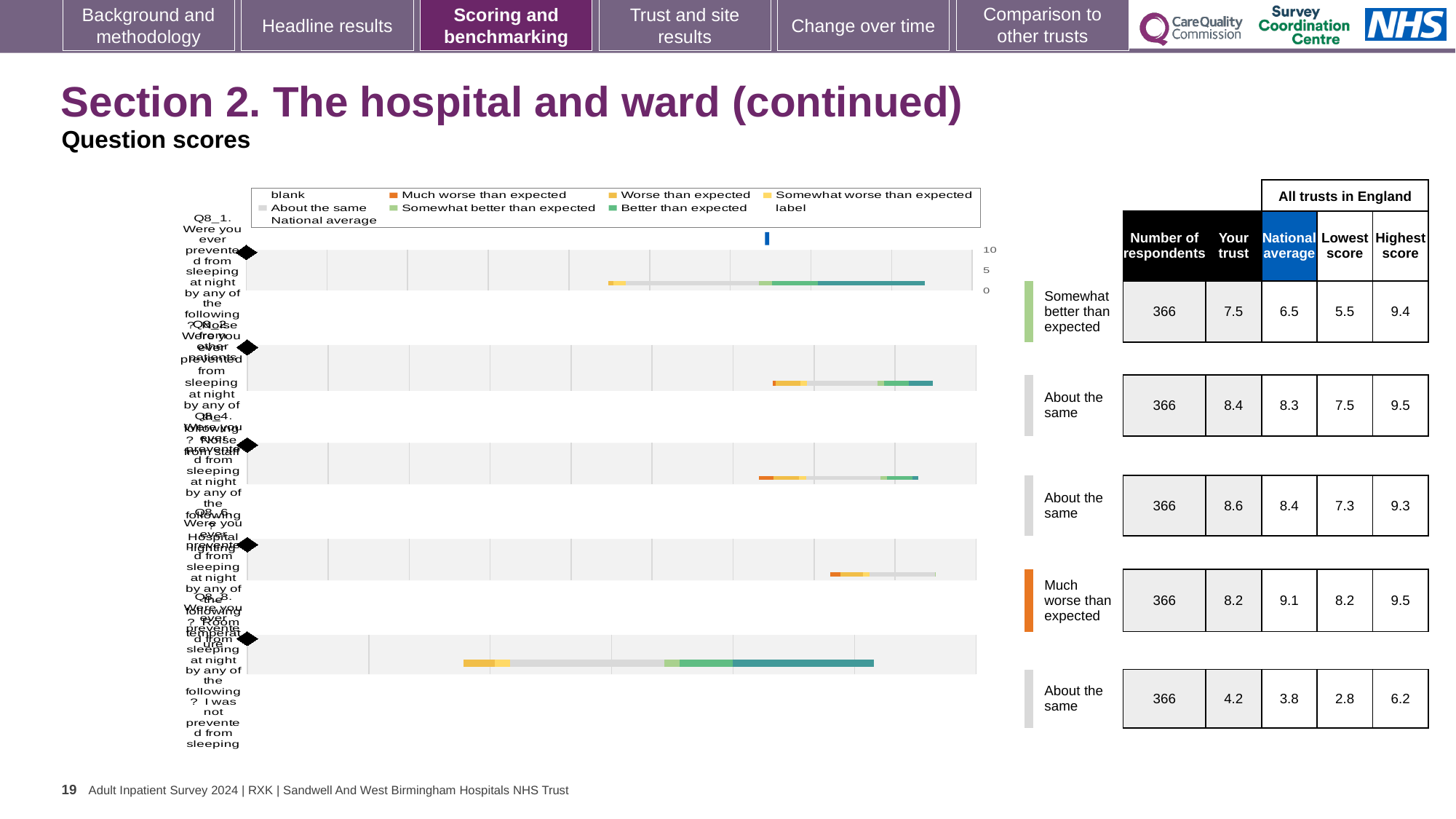
How many question rows (bars) are plotted in the chart? 5 What benchmark label is given to the fourth row of the chart? Much worse than expected For the bottom row, what is the difference between the highest score and the lowest score? 3.4 For the fourth row, how much higher is the national average than the 'Your trust' score? 0.9 How many respondents are listed for the top row? 366 What is the 'Your trust' score for the top row of the chart? 7.5 What kind of chart is shown on the left of the slide? bar chart What benchmark label is given to the top row of the chart? Somewhat better than expected Which row has the highest 'Your trust' score? the third row (8.6) Which row has the lowest 'Your trust' score? the bottom row (4.2) What is the national average for the second row of the chart? 8.3 For the third row, which is larger: the 'Your trust' score or the national average? Your trust